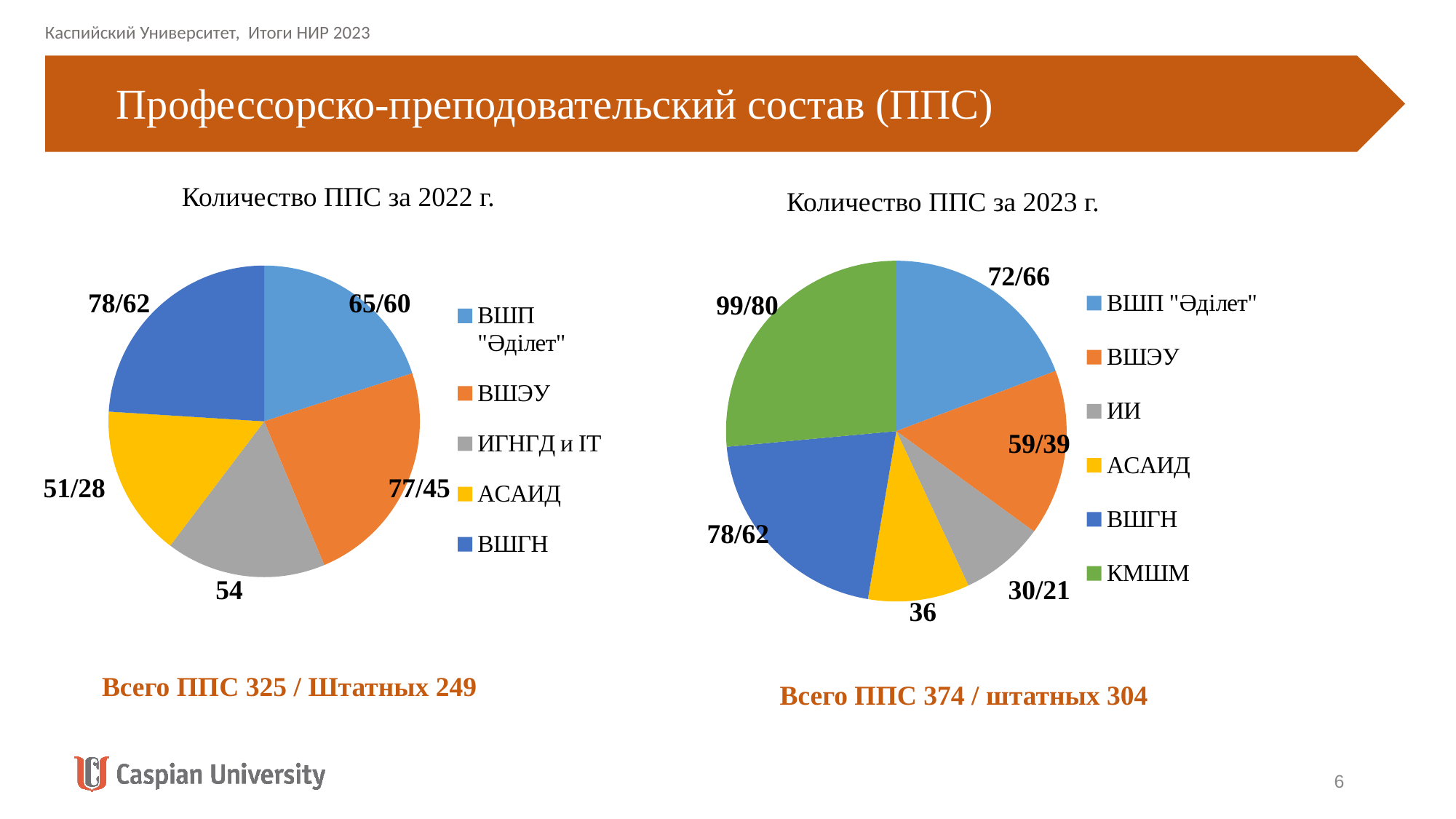
In the chart titled "Количество ППС за 2023 г.", by how much does the first number in the label for КМШМ (99) exceed the first number in the label for ИИ (30)? 69 What type of chart is used for "Количество ППС за 2023 г."? Pie chart In the chart titled "Количество ППС за 2022 г.", what is the data label for ВШГН? 78/62 In the chart titled "Количество ППС за 2023 г.", which category has the smallest slice? ИИ How many slices does the chart titled "Количество ППС за 2022 г." have? 5 In the chart titled "Количество ППС за 2023 г.", which category has the largest slice? КМШМ In the chart titled "Количество ППС за 2023 г.", what colour is the КМШМ slice? Green How many slices does the chart titled "Количество ППС за 2023 г." have? 6 In the chart titled "Количество ППС за 2023 г.", which slice is larger: ВШП "Әділет" or АСАИД? ВШП "Әділет" In the chart titled "Количество ППС за 2023 г.", what is the data label for ВШЭУ? 59/39 In the chart titled "Количество ППС за 2022 г.", what is the data label for ИГНГД и IT? 54 In the chart titled "Количество ППС за 2023 г.", what is the data label for КМШМ? 99/80